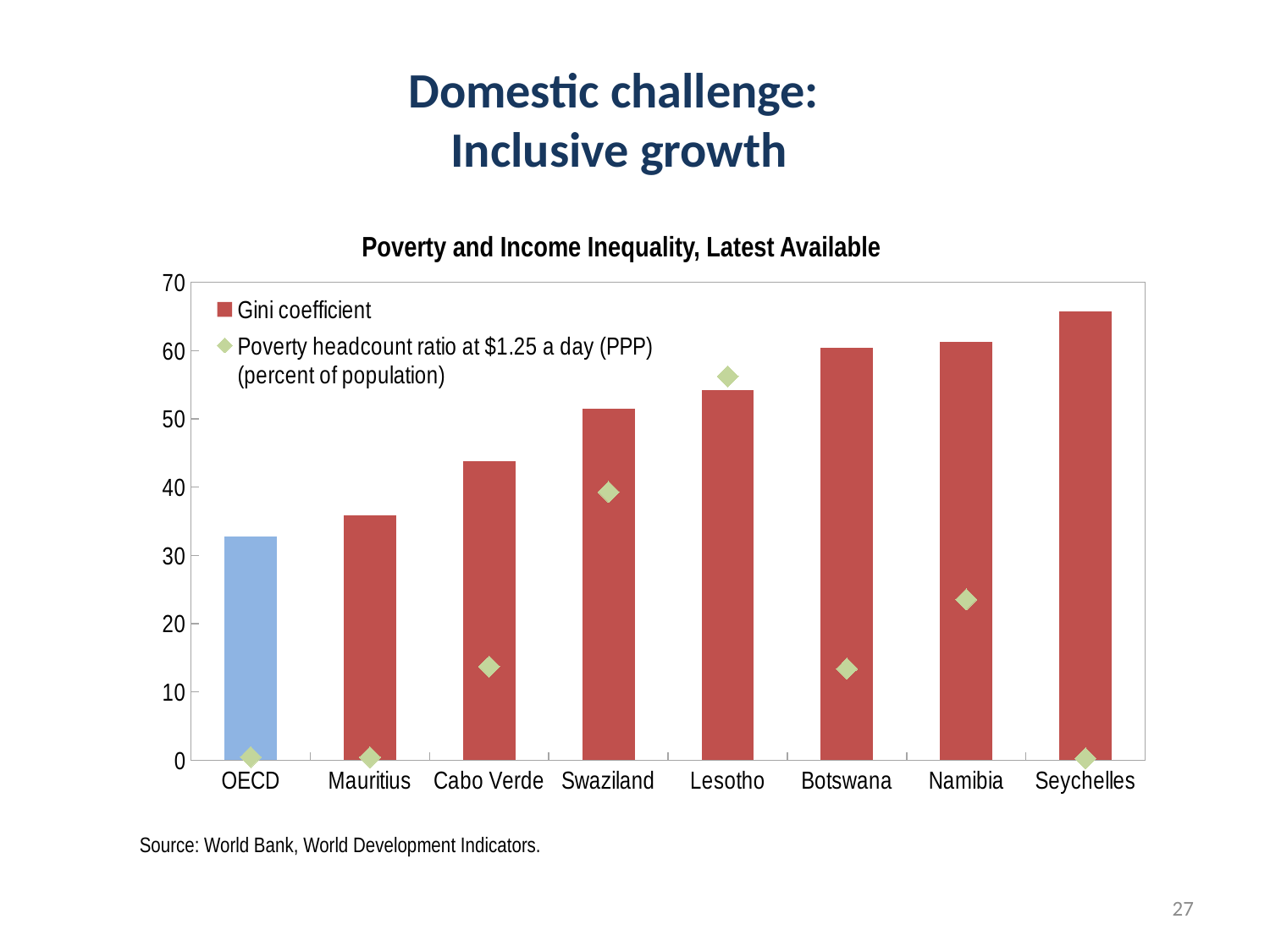
Is the Gini coefficient for Cabo Verde greater or less than 40? greater How many categories are shown on the x axis? 8 Which has a higher Gini coefficient, Swaziland or Botswana? Botswana Which category has the highest Gini coefficient? Seychelles What is the title of the chart? Poverty and Income Inequality, Latest Available How many series does the legend list? 2 Is the Gini coefficient for Mauritius greater or less than 40? less What kind of chart is shown on the slide? bar chart with diamond markers Which category has the highest poverty headcount ratio at $1.25 a day? Lesotho Which category has the lowest Gini coefficient? OECD Is the poverty headcount ratio for Namibia greater or less than 20? greater Do the Gini coefficient bars rise or fall from left to right across the x axis? rise